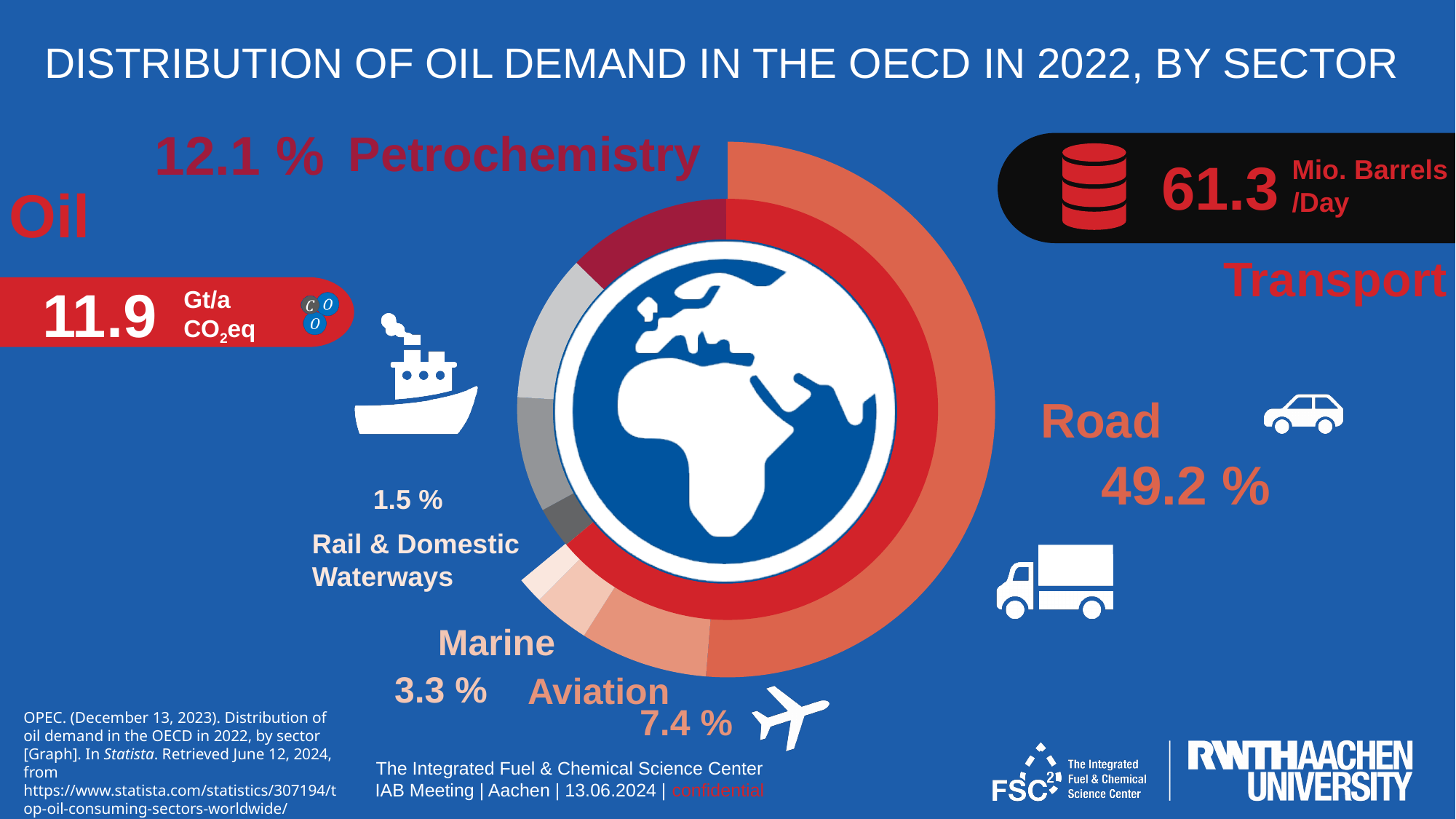
What kind of chart is used to show the distribution of oil demand? Pie (donut) chart What is the combined share of the four transport sub-sectors (Road, Aviation, Marine, Rail & Domestic Waterways)? 61.4 % What share of oil demand is attributed to Rail & Domestic Waterways? 1.5 % What is the percentage shown for Aviation? 7.4 % Which has a larger share of oil demand, Aviation or Marine? Aviation By how many percentage points does the Road share exceed the Petrochemistry share? 37.1 What is the percentage shown for Marine? 3.3 % Which labelled sector has the smallest share of oil demand? Rail & Domestic Waterways What percentage of OECD oil demand in 2022 is attributed to the Road sector? 49.2 % What is the total OECD oil demand shown in million barrels per day? 61.3 Mio. Barrels/Day Which labelled sector has the largest share of oil demand? Road What share of oil demand does Petrochemistry account for? 12.1 %